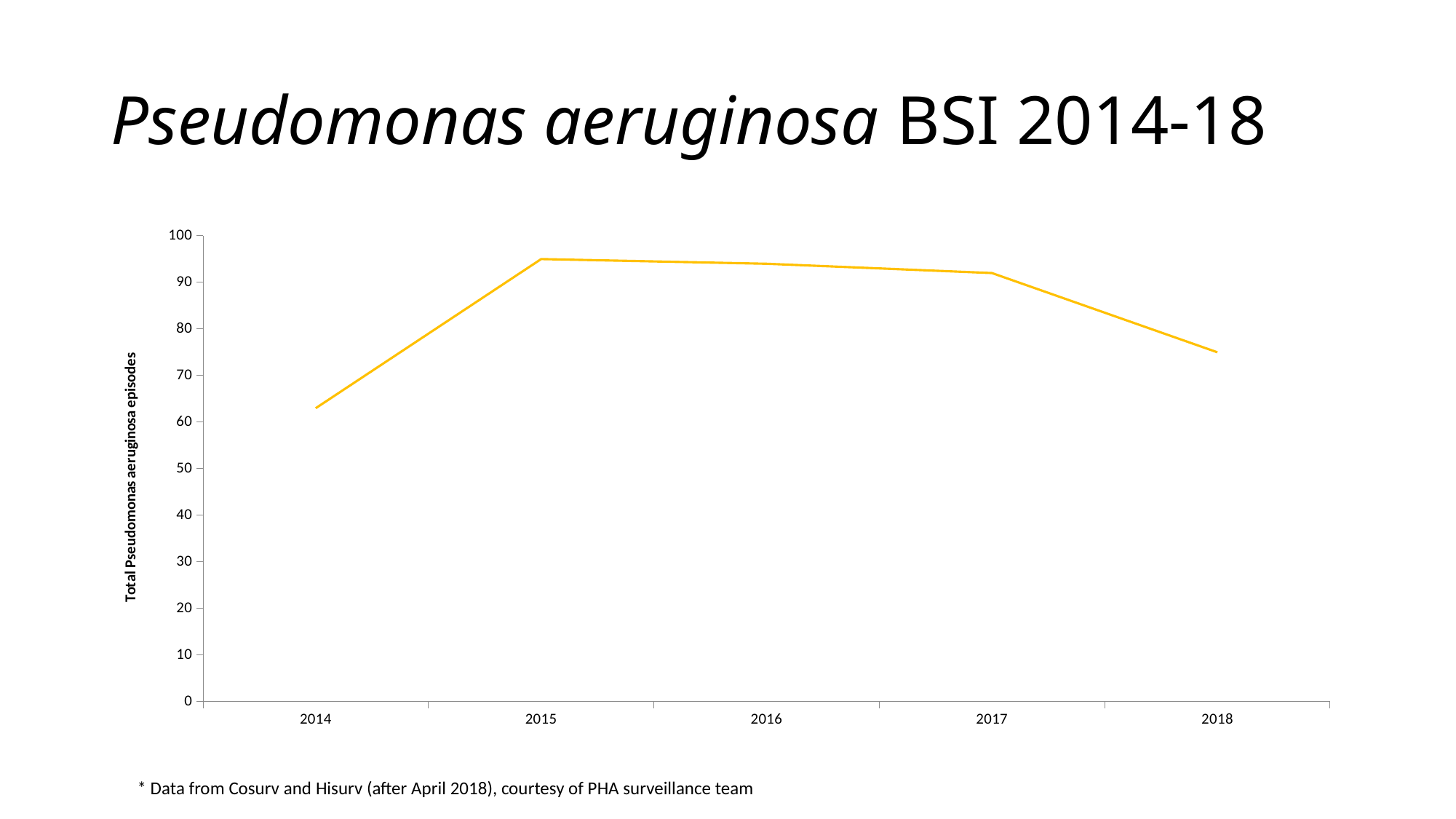
Which year has the larger value, 2015 or 2018? 2015 Which year has the larger value, 2014 or 2018? 2018 Is the value for 2015 greater or less than 90? greater Is the value for 2014 greater or less than 70? less Do the values rise or fall from 2015 to 2018? fall Which year has the lowest number of Pseudomonas aeruginosa episodes? 2014 What kind of chart is shown on the slide? line chart Is the value for 2016 greater or less than 90? greater Do the values rise or fall from 2014 to 2015? rise How many years are plotted on the x axis? 5 What is the label on the vertical axis? Total Pseudomonas aeruginosa episodes